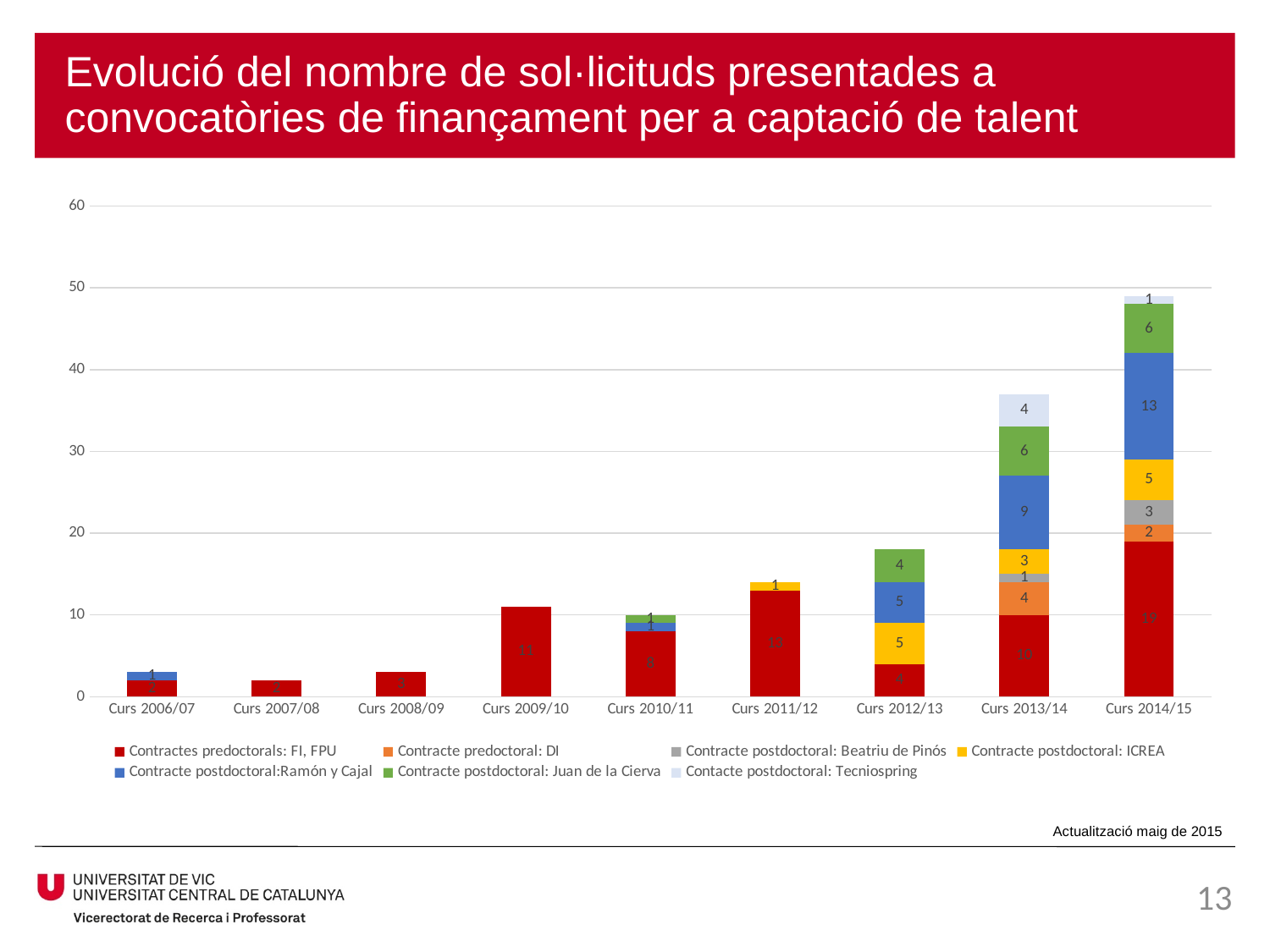
What is the total of the stacked bar for Curs 2012/13? 18 Which academic year has the tallest stacked bar? Curs 2014/15 What is the value for Contracte postdoctoral: Juan de la Cierva in Curs 2013/14? 6 What is the value for Contracte postdoctoral:Ramón y Cajal in Curs 2014/15? 13 Is the total for Curs 2013/14 greater or less than 30? greater What is the value for Contracte postdoctoral: ICREA in Curs 2012/13? 5 How many academic years (categories) are shown on the x axis? 9 What is the difference between the Ramón y Cajal values for Curs 2014/15 and Curs 2013/14? 4 How many series does the legend list? 7 What type of chart is shown on the slide? Stacked bar chart Which is larger: Contracte postdoctoral: Beatriu de Pinós in Curs 2014/15 or in Curs 2013/14? Curs 2014/15 What is the value for Contracte predoctoral: DI in Curs 2013/14? 4